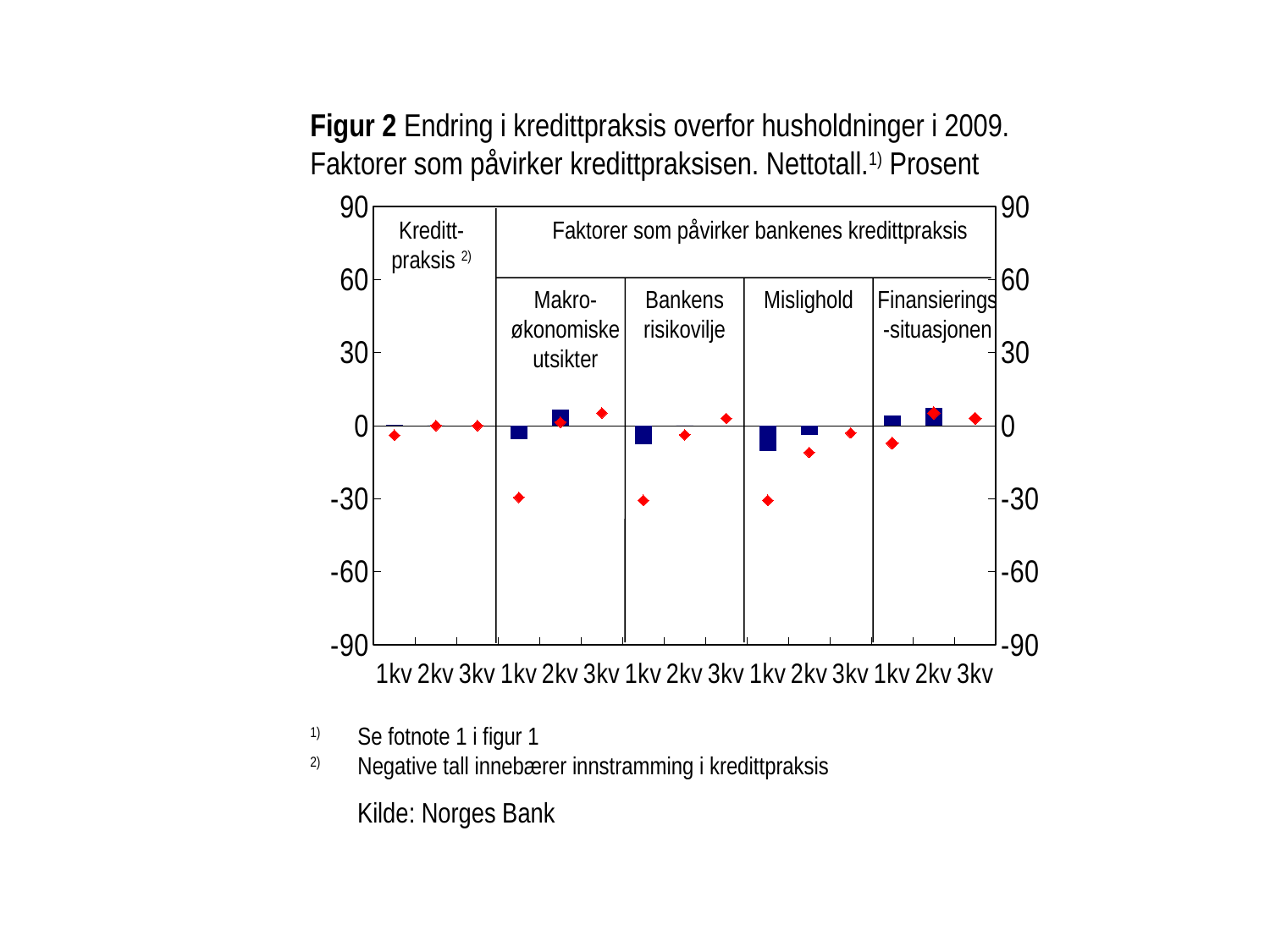
Which is larger, the blue bar for 1kv under 'Mislighold' or the blue bar for 2kv under 'Makro-økonomiske utsikter'? 2kv under Makro-økonomiske utsikter Is the red diamond value for 1kv under 'Bankens risikovilje' greater or less than 0? less Is the blue bar value for 2kv under 'Finansierings-situasjonen' greater or less than 30? less Is the red diamond value for 1kv under 'Makro-økonomiske utsikter' greater or less than 0? less Do the red diamond values rise or fall from 1kv to 3kv in the 'Mislighold' panel? rise How many factor panels are grouped under 'Faktorer som påvirker bankenes kredittpraksis'? 4 What are the minimum and maximum values shown on the vertical axis? -90 and 90 Which quarter has the lowest blue bar in the 'Mislighold' panel? 1kv What is the title of the chart? Figur 2 Endring i kredittpraksis overfor husholdninger i 2009. Faktorer som påvirker kredittpraksisen. Nettotall. Prosent What kind of chart is used to show the blue values? bar chart How many quarter categories are shown along the x axis in total? 15